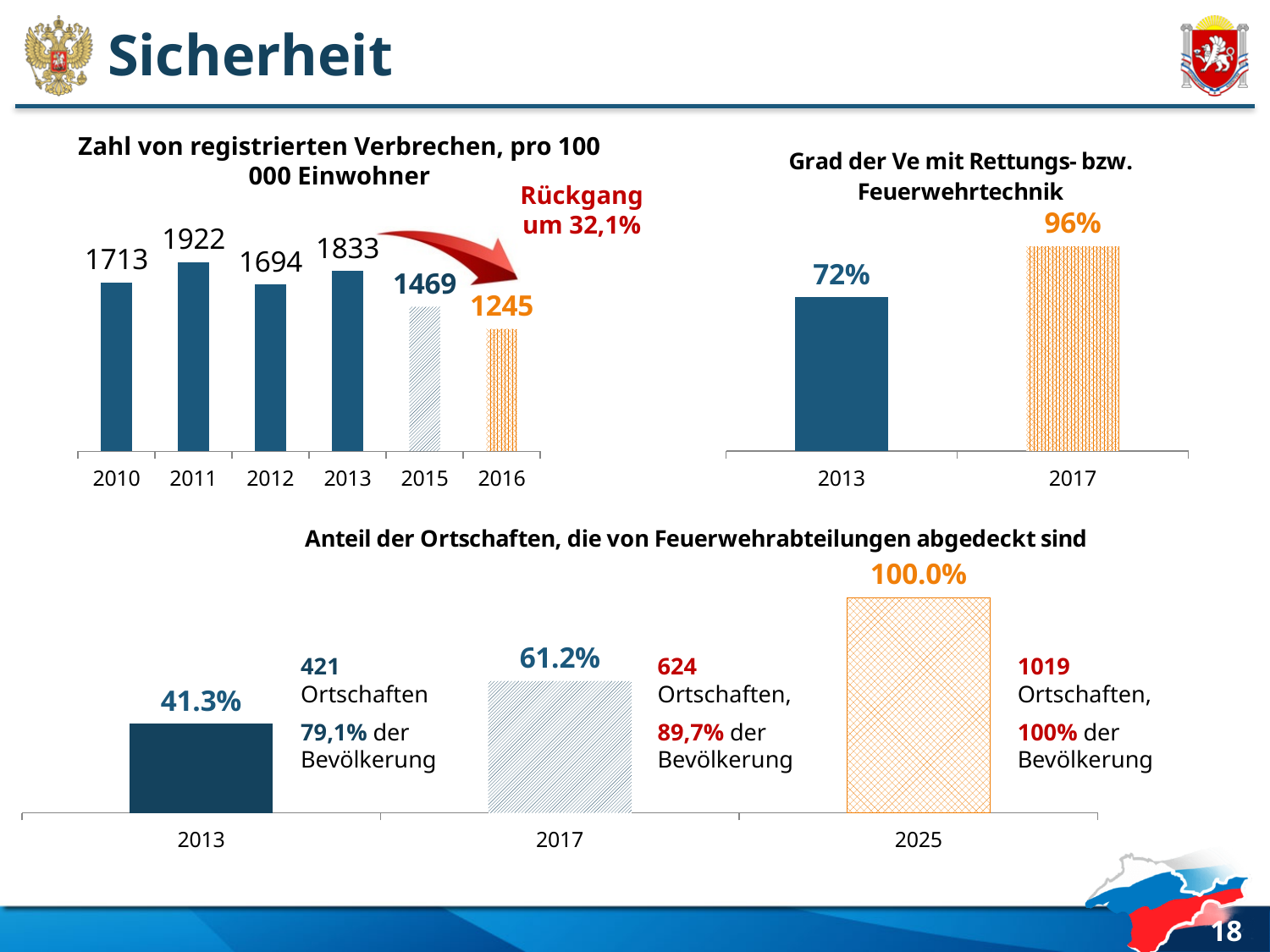
In the chart 'Zahl von registrierten Verbrechen, pro 100 000 Einwohner', how many years are shown on the x axis? 6 What kind of chart is 'Grad der Ve mit Rettungs- bzw. Feuerwehrtechnik'? bar chart In the chart 'Zahl von registrierten Verbrechen, pro 100 000 Einwohner', is the value for 2010 or 2012 larger? 2010 In the chart 'Anteil der Ortschaften, die von Feuerwehrabteilungen abgedeckt sind', do the values rise or fall from 2013 to 2025? rise In the chart 'Grad der Ve mit Rettungs- bzw. Feuerwehrtechnik', what is the value for 2013? 72% In the chart 'Zahl von registrierten Verbrechen, pro 100 000 Einwohner', what is the value for 2011? 1922 In the chart 'Anteil der Ortschaften, die von Feuerwehrabteilungen abgedeckt sind', what is the value for 2017? 61.2% In the chart 'Anteil der Ortschaften, die von Feuerwehrabteilungen abgedeckt sind', how many years are shown on the x axis? 3 In the chart 'Grad der Ve mit Rettungs- bzw. Feuerwehrtechnik', what is the difference between the 2017 and 2013 values? 24% In the chart 'Zahl von registrierten Verbrechen, pro 100 000 Einwohner', what is the difference between the values for 2013 and 2015? 364 In the chart 'Zahl von registrierten Verbrechen, pro 100 000 Einwohner', which year has the lowest value? 2016 In the chart 'Zahl von registrierten Verbrechen, pro 100 000 Einwohner', which year has the highest value? 2011